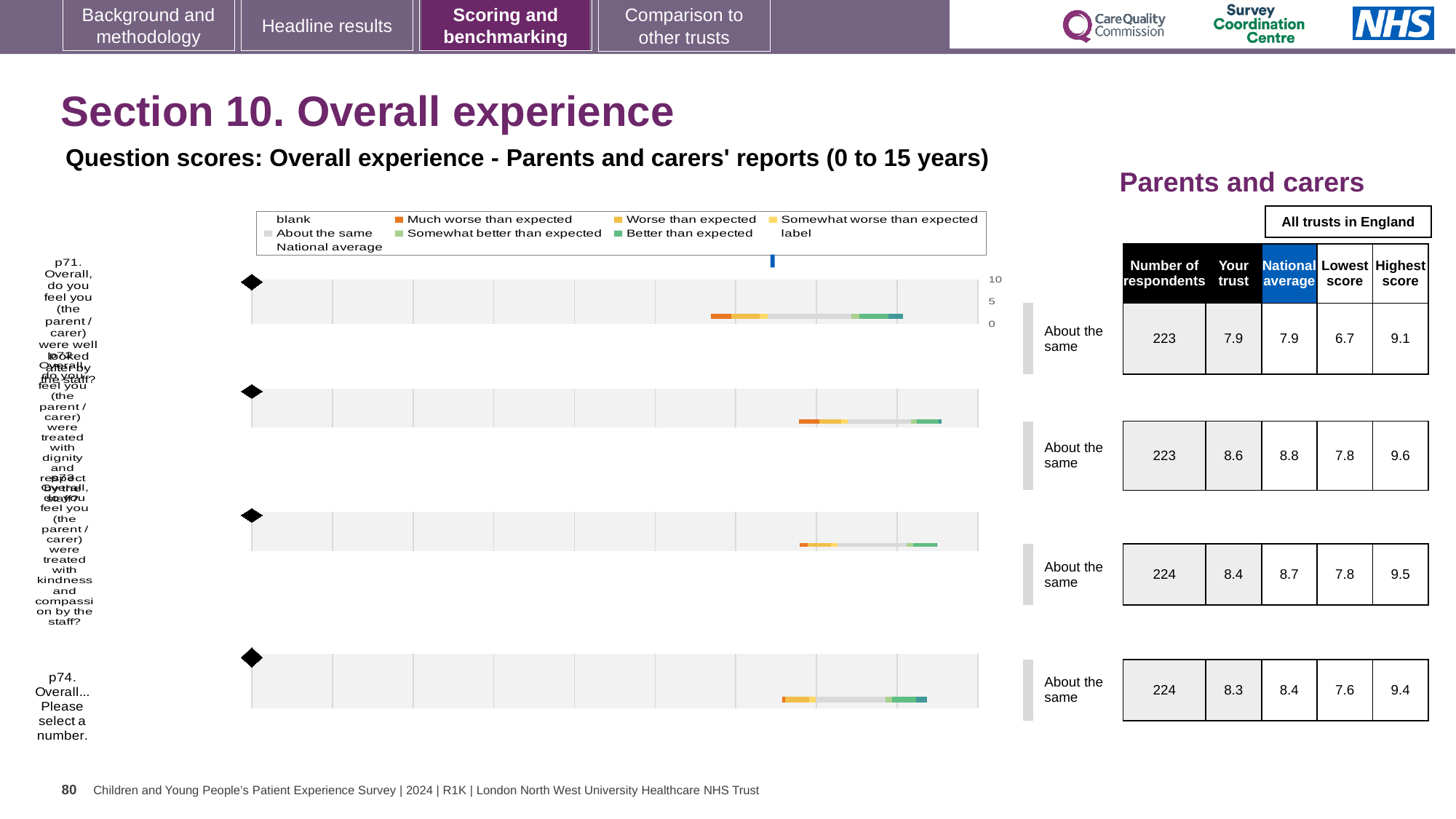
What is the highest score across all trusts in England for p72? 9.6 What is the national average score for p74? 8.4 What is the lowest score across all trusts in England for p74? 7.6 For p72, how much higher is the national average than the 'Your trust' score? 0.2 How many questions (rows) are plotted in the chart? 4 Which question has the highest 'Your trust' score? p72 For p73, which is larger: the 'Your trust' score or the national average? National average How many respondents answered p71? 223 What is the 'Your trust' score for p74 (Overall... Please select a number)? 8.3 Which question has the lowest 'Your trust' score? p71 What kind of chart is used to show the question scores on this slide? bar chart What benchmark category is shown for p74? About the same